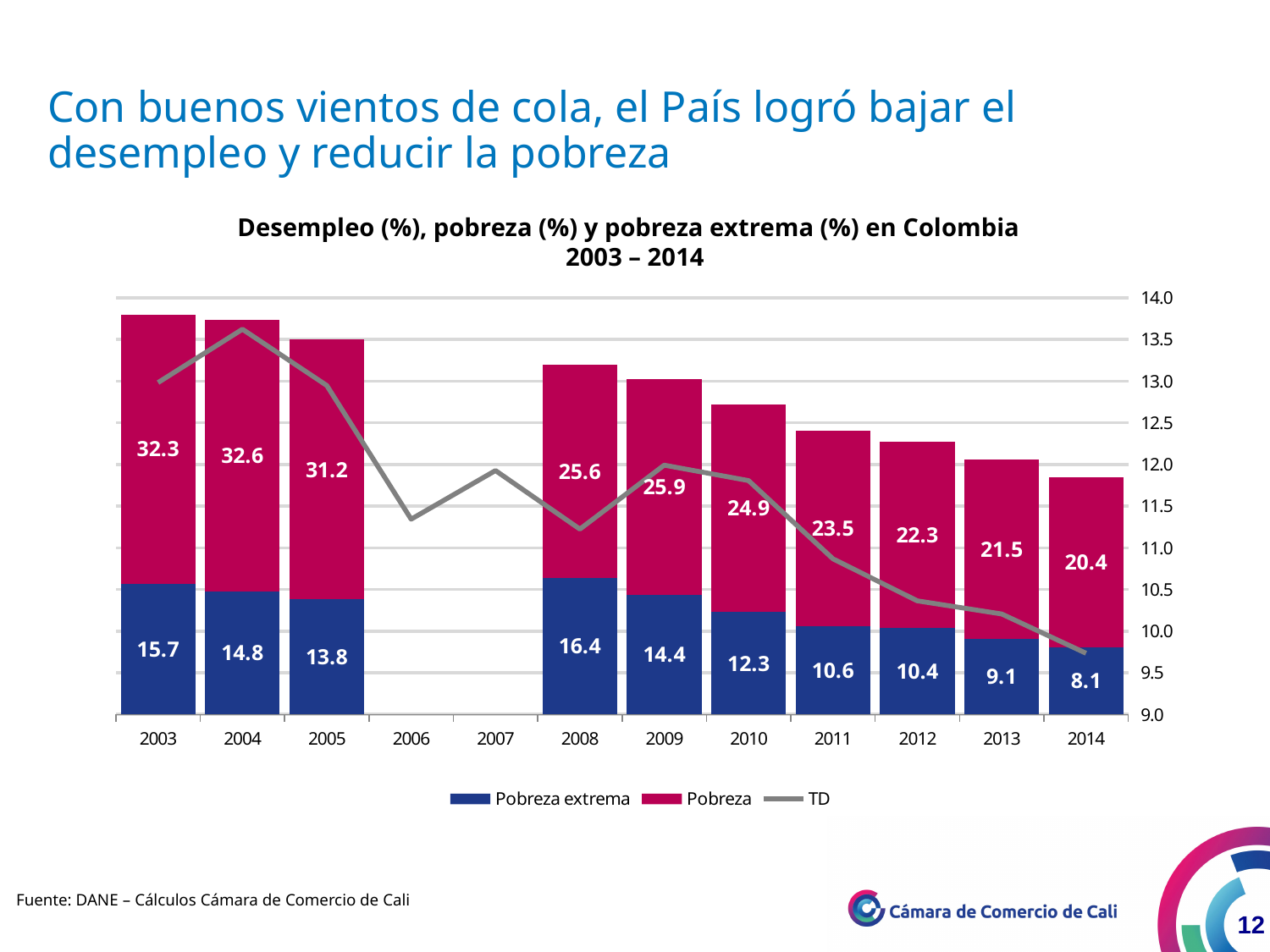
What is the Pobreza extrema value for 2008? 16.4 What is the Pobreza value for 2010? 24.9 What is the difference between the Pobreza extrema values for 2008 and 2014? 8.3 Is the TD value for 2004 greater or less than 13.0? greater Does the Pobreza value rise or fall from 2008 to 2014? fall Which is larger, the Pobreza extrema value for 2009 or for 2010? 2009 How many years are shown on the x axis? 12 How many series does the legend list? 3 What is the difference between the Pobreza values for 2003 and 2014? 11.9 Which year has the lowest Pobreza extrema value? 2014 Which year has the highest Pobreza value? 2004 Is the TD value for 2006 greater or less than 12.0? less